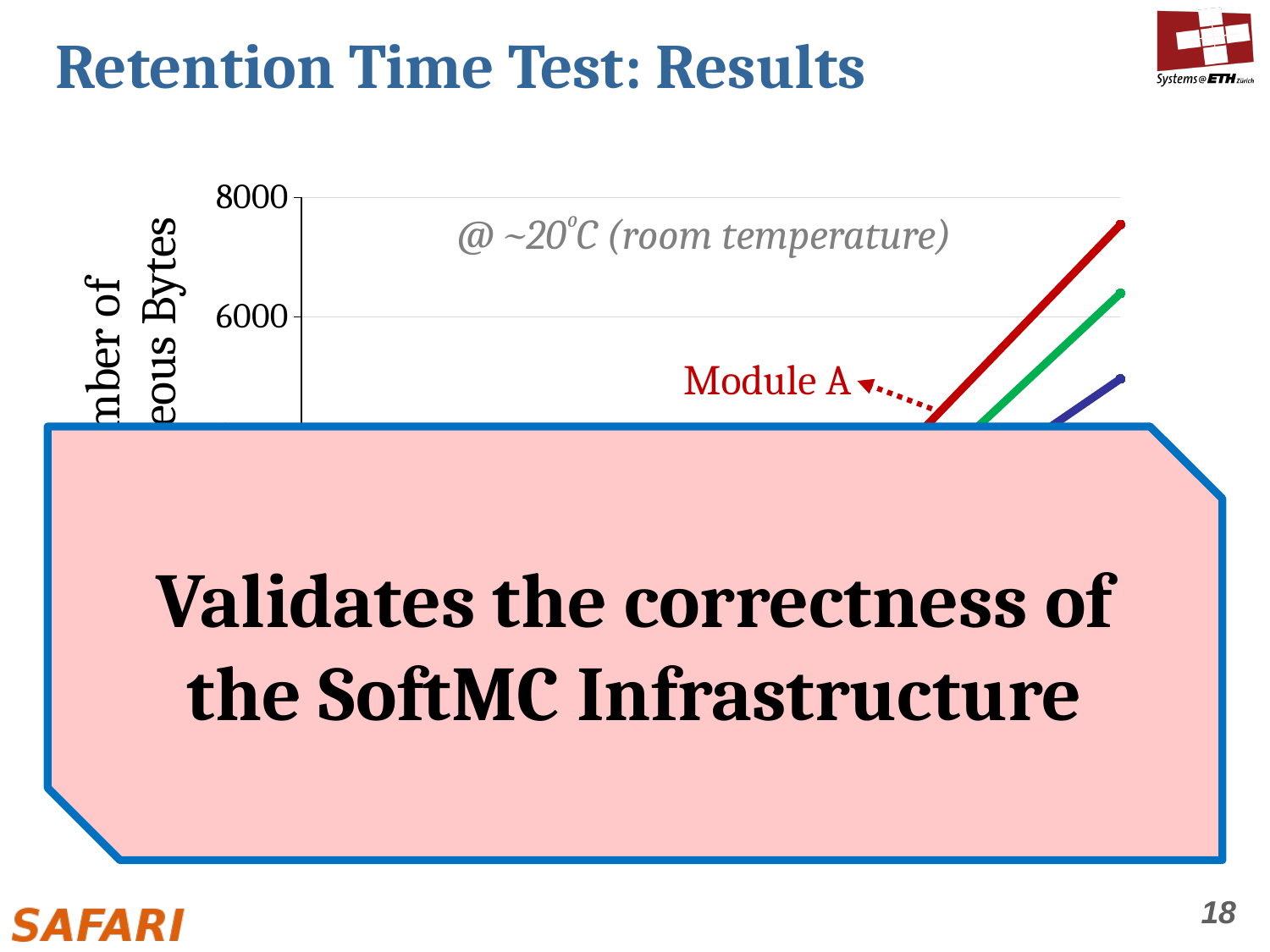
Is the highest value reached by the Module A line greater or less than 6000? greater Is the highest value reached by the Module A line greater or less than 8000? less At what temperature does the chart annotation say the test was run? ~20°C (room temperature) What kind of chart is shown on the slide? line chart Do the plotted lines rise or fall as they move to the right along the x axis? rise Which line reaches the highest value at the right edge of the chart? Module A What colour is the line labelled Module A? red How many lines are plotted on the chart? 3 What is the topmost tick value shown on the y axis? 8000